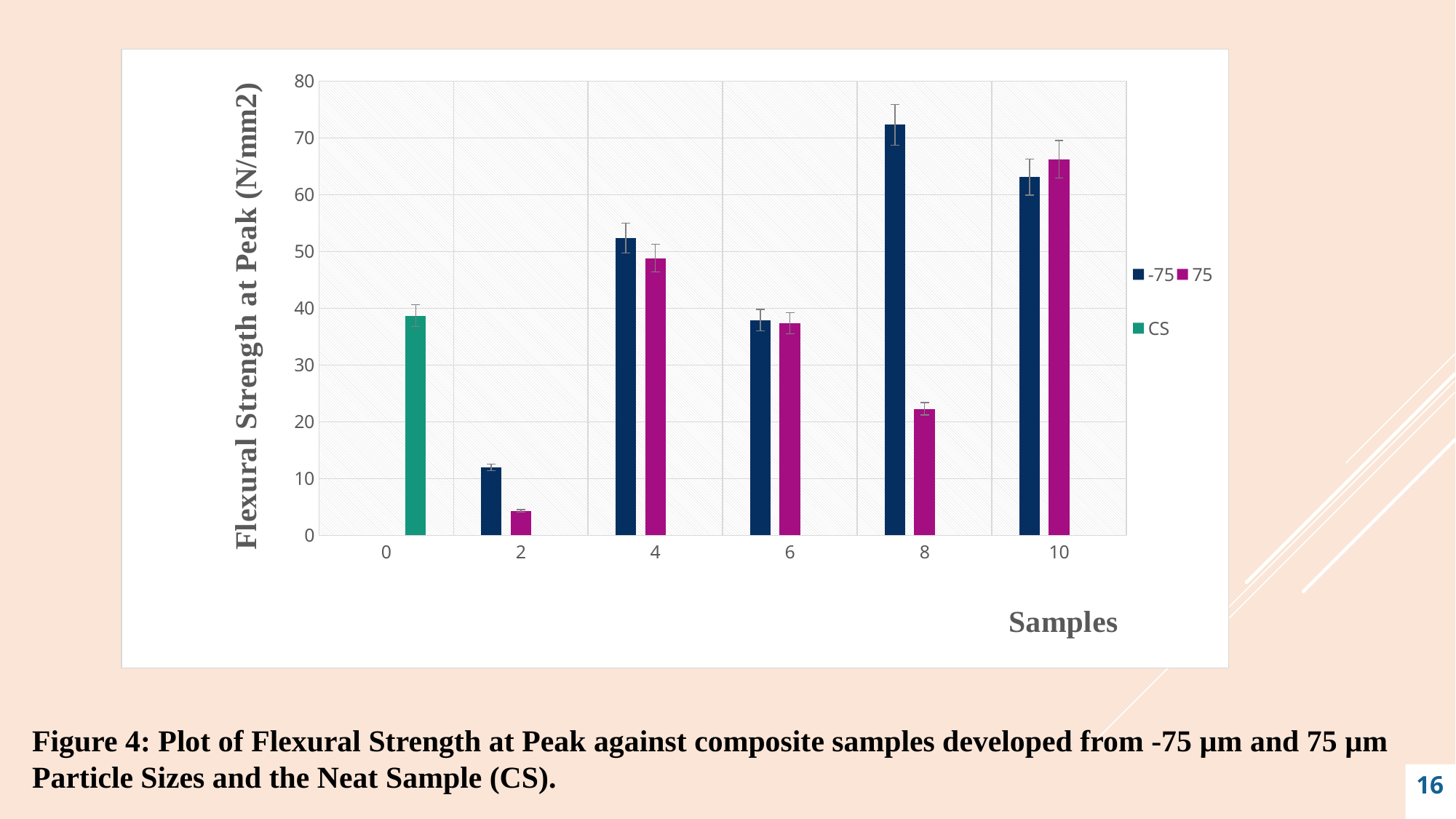
Which sample has the highest -75 bar? 8 At sample 2, which series has the larger value, -75 or 75? -75 What are the series names listed in the legend? -75, 75, CS Is the value of the CS bar at sample 0 greater or less than 30? greater At sample 8, which series has the larger value, -75 or 75? -75 Which sample has the lowest 75 bar? 2 What is the y-axis title of the chart? Flexural Strength at Peak (N/mm2) Is the value of the 75 series at sample 8 greater or less than 30? less How many series does the legend list? 3 Is the value of the 75 series at sample 2 greater or less than 10? less What kind of chart is shown on the slide? bar chart